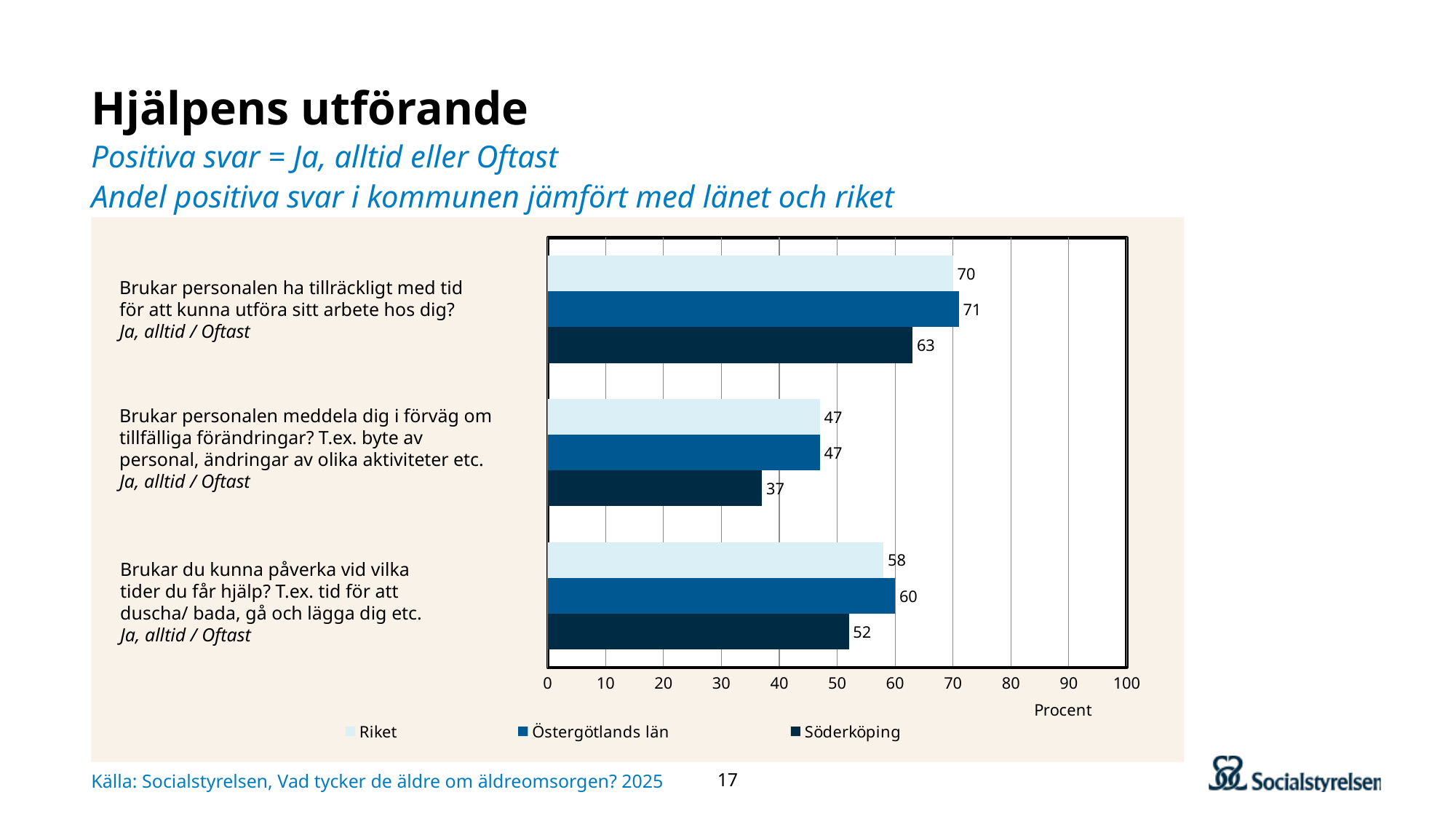
What is the value for Söderköping on the question "Brukar personalen ha tillräckligt med tid för att kunna utföra sitt arbete hos dig?"? 63 Is the value for Söderköping on the question "Brukar personalen meddela dig i förväg om tillfälliga förändringar?" greater or less than 40? less What is the value for Östergötlands län on the question "Brukar du kunna påverka vid vilka tider du får hjälp?"? 60 What is the difference between Östergötlands län and Söderköping on the question "Brukar du kunna påverka vid vilka tider du får hjälp?"? 8 Which is larger on the question "Brukar du kunna påverka vid vilka tider du får hjälp?": Riket or Söderköping? Riket Which series has the lowest value on the question "Brukar personalen meddela dig i förväg om tillfälliga förändringar?"? Söderköping What kind of chart is shown on the slide? Bar chart What is the difference between Riket and Söderköping on the question "Brukar personalen meddela dig i förväg om tillfälliga förändringar?"? 10 What is the value for Riket on the question "Brukar personalen meddela dig i förväg om tillfälliga förändringar?"? 47 Which series has the highest value on the question "Brukar personalen ha tillräckligt med tid för att kunna utföra sitt arbete hos dig?"? Östergötlands län How many question categories are shown in the chart? 3 How many series does the legend list? 3